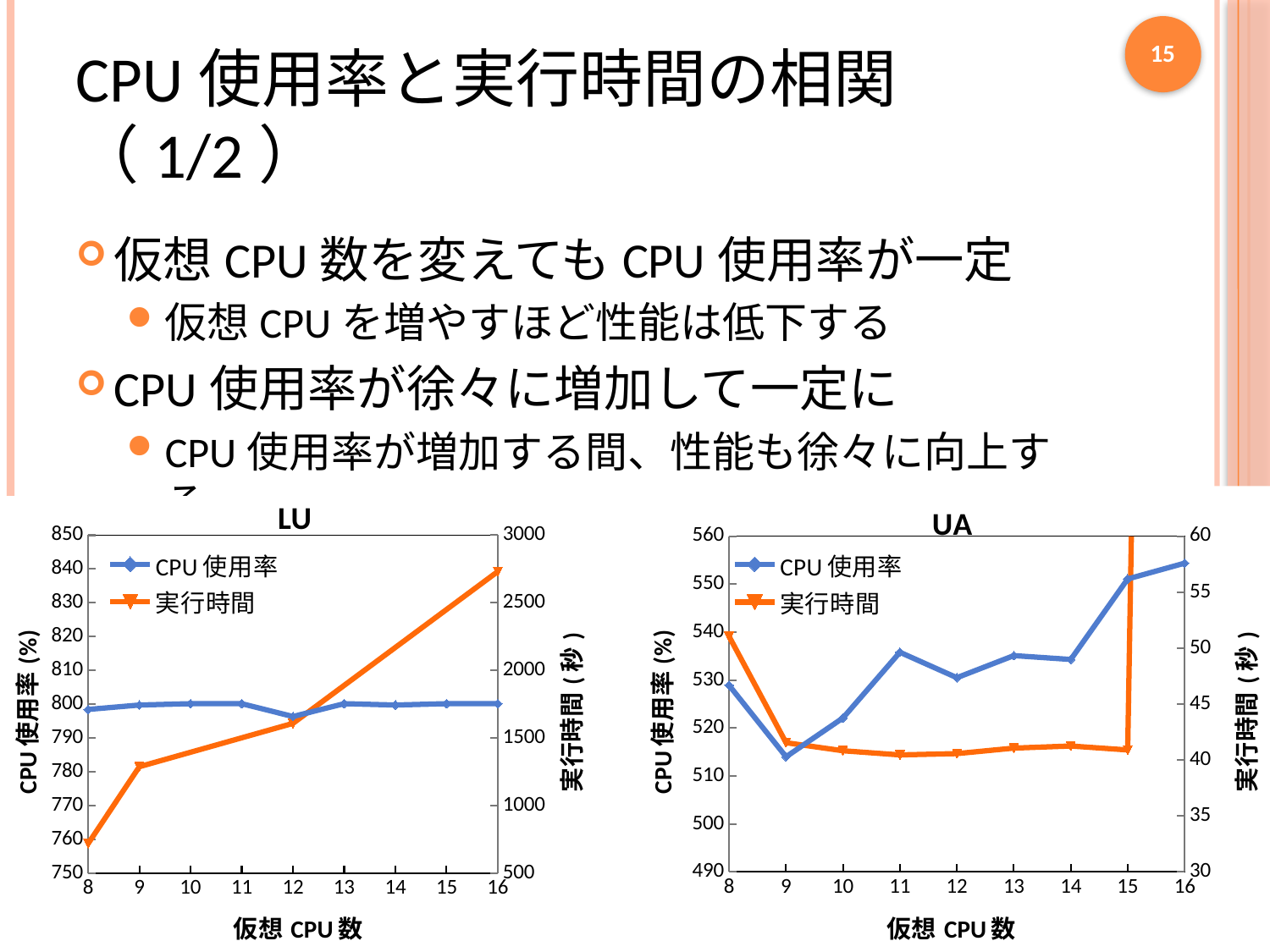
In the UA chart, is the 実行時間 value at 10 virtual CPUs greater or less than 45? less How many virtual CPU counts (x-axis points) are plotted in the LU chart? 9 How many series does the legend of the UA chart list? 2 In the LU chart, which colour is used for the 実行時間 series? orange In the UA chart, is the CPU 使用率 value at 9 virtual CPUs greater or less than 520? less What kind of chart is the LU chart? line chart In the LU chart, is the 実行時間 value at 16 virtual CPUs greater or less than 2500? greater In the LU chart, does the 実行時間 series rise or fall as 仮想 CPU 数 increases from 8 to 16? rise What is the title of the chart on the right side of the slide? UA